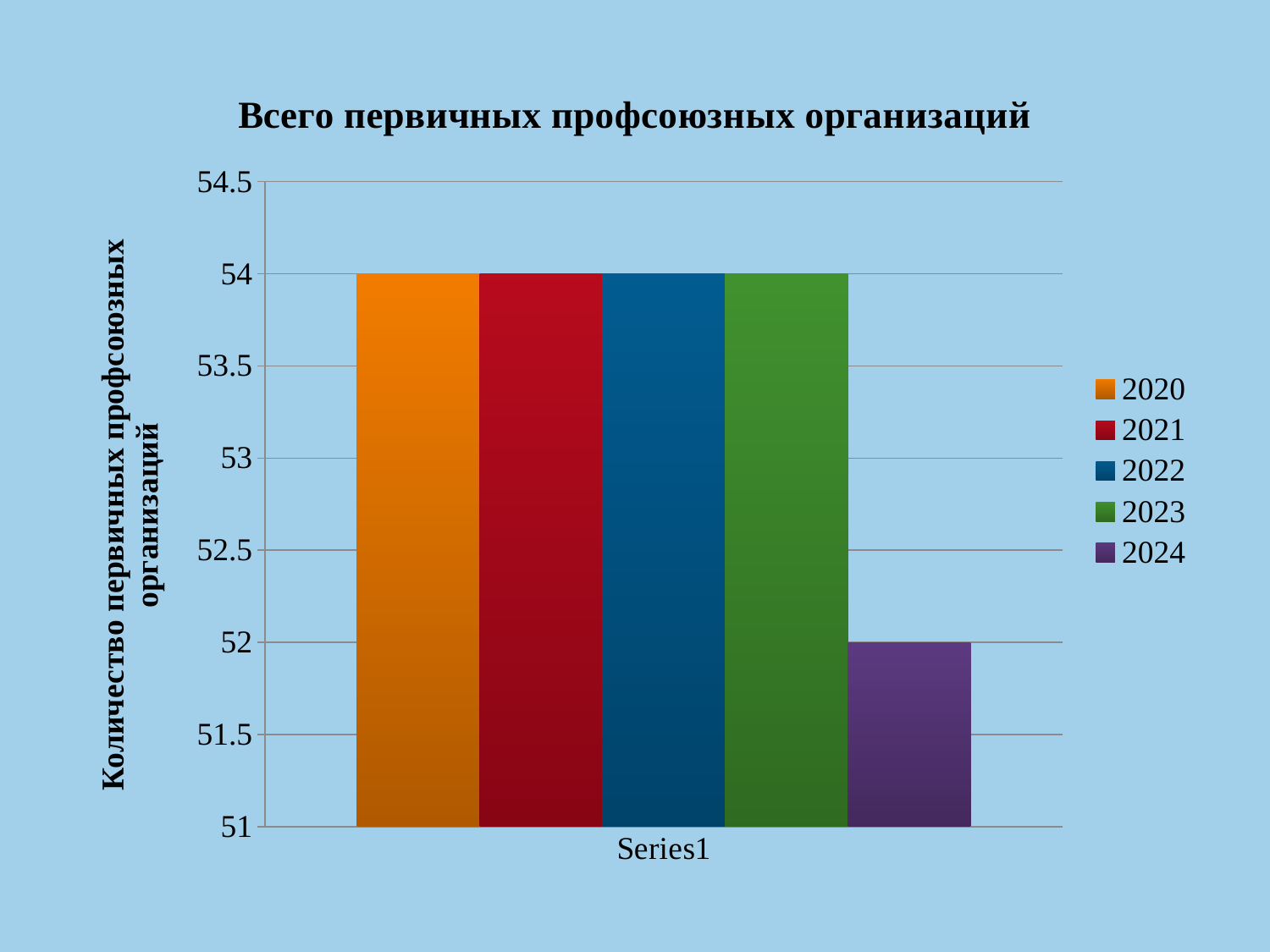
What kind of chart is shown on the slide? bar chart Is the value for 2024 greater or less than 53? less What is the title of the chart? Всего первичных профсоюзных организаций What is the value for 2020? 54 Do the values rise or fall from 2023 to 2024? fall What is the value for 2024? 52 How many series does the legend list? 5 Is the value for 2020 greater or less than 53.5? greater Which is larger, the value for 2021 or the value for 2024? 2021 What is the value for 2022? 54 What is the difference between the values for 2023 and 2024? 2 Which year has the lowest value? 2024